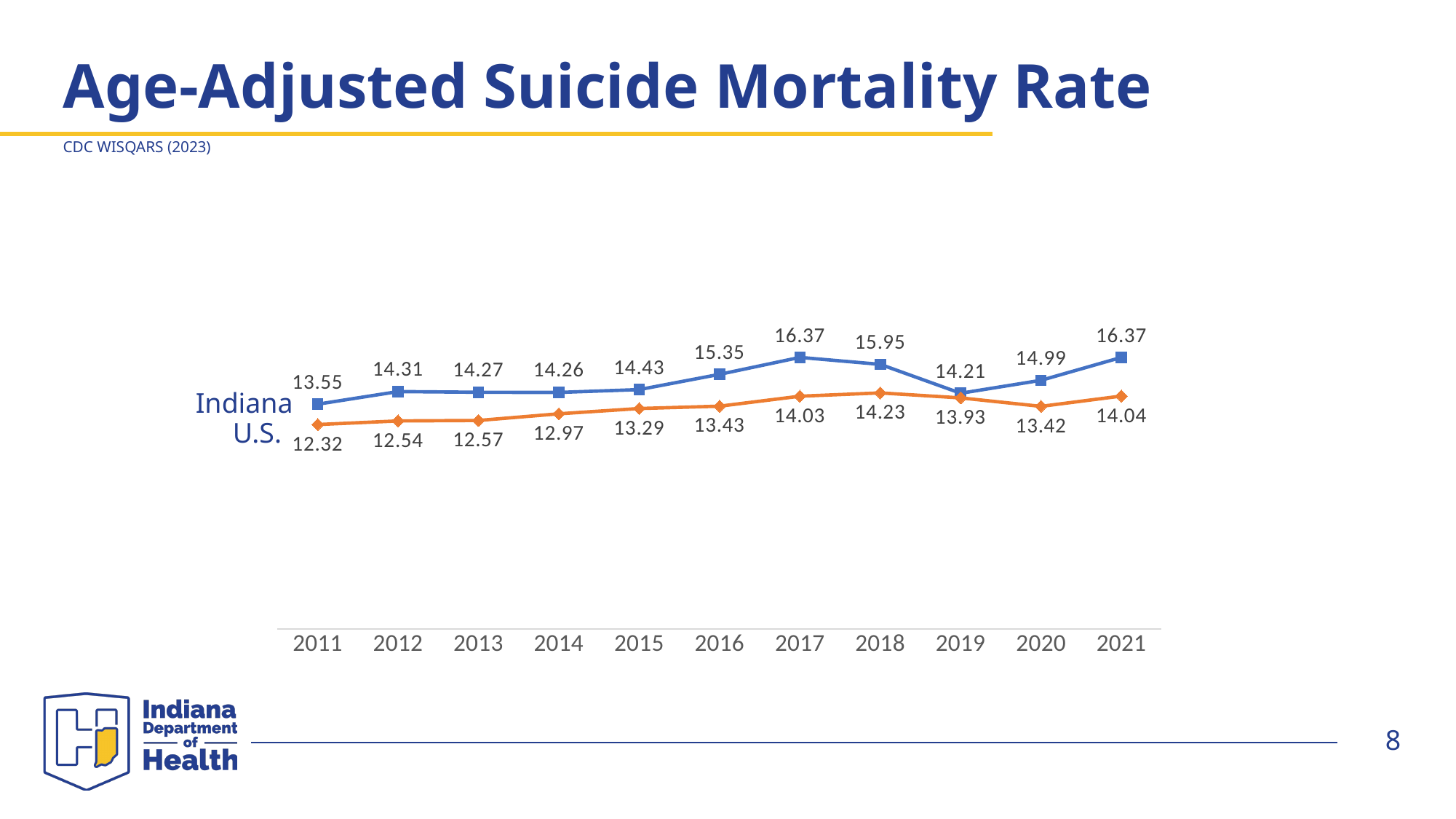
What is the difference between Indiana's and the U.S. rate in 2021? 2.33 How many years are shown on the x axis? 11 Which was higher in 2016, Indiana's rate or the U.S. rate? Indiana In which year was Indiana's rate lowest? 2011 What was Indiana's age-adjusted suicide mortality rate in 2017? 16.37 What was Indiana's rate in 2019? 14.21 Did the U.S. rate rise or fall from 2011 to 2018? Rise What was the U.S. age-adjusted suicide mortality rate in 2011? 12.32 How many series does the chart show? 2 What was the U.S. rate in 2020? 13.42 What kind of chart is shown on the slide? Line chart In which year was the U.S. rate highest? 2018